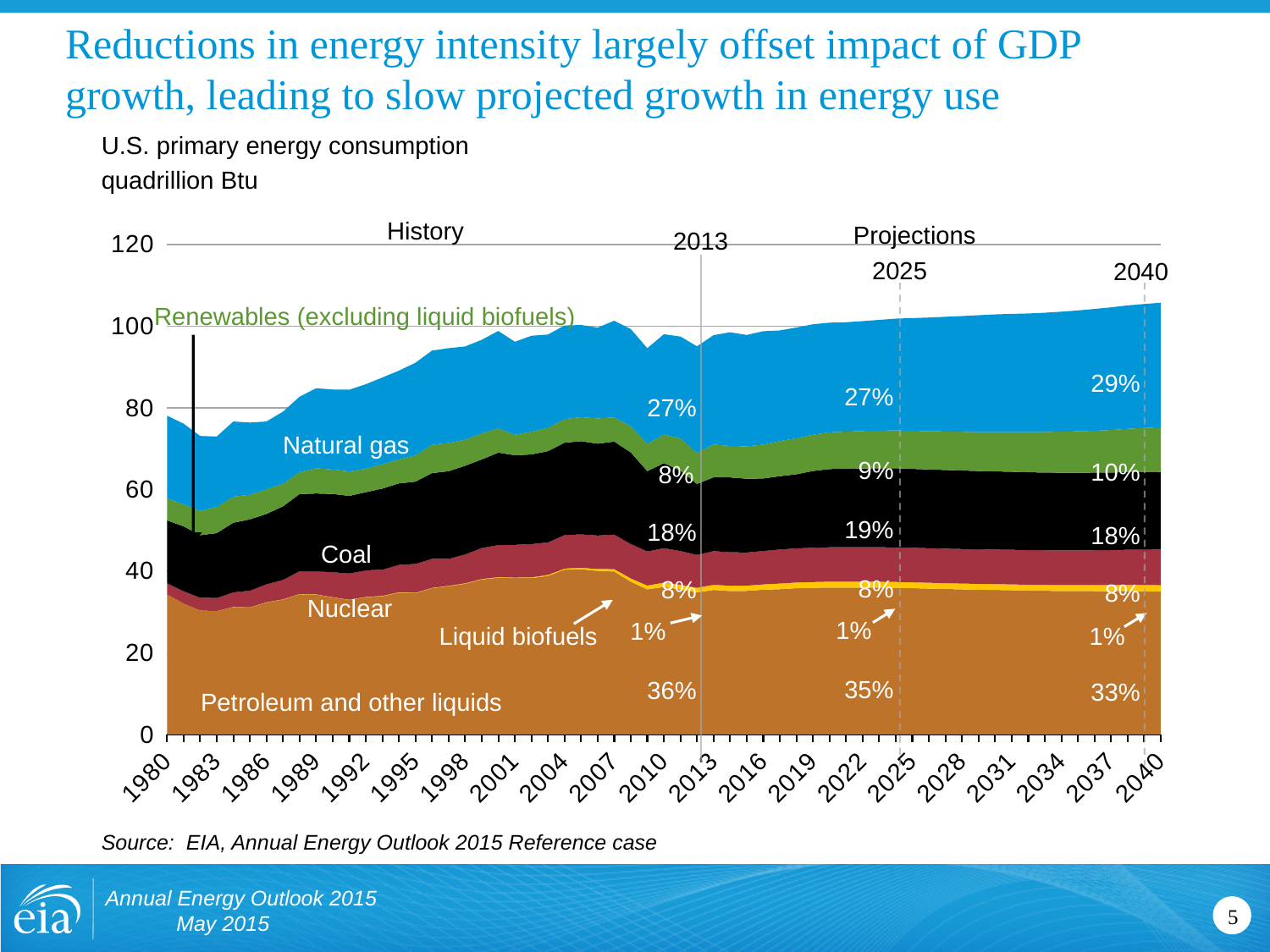
Is total U.S. primary energy consumption in 2040 greater or less than 100 quadrillion Btu? greater What kind of chart is used to show U.S. primary energy consumption? Stacked area chart What share of U.S. primary energy consumption does natural gas account for in 2040? 29% Which energy source has the smallest share of U.S. primary energy consumption in 2025? Liquid biofuels Which energy source has the largest share of U.S. primary energy consumption in 2013? Petroleum and other liquids Does the share of natural gas in U.S. primary energy consumption rise or fall between 2013 and 2040? Rise What share of U.S. primary energy consumption does coal account for in 2025? 19% In 2040, which has the larger share of U.S. primary energy consumption: natural gas or petroleum and other liquids? Petroleum and other liquids By how many percentage points does the share of petroleum and other liquids fall between 2013 and 2040? 3 percentage points How many energy sources are shown as separate areas in the chart? 6 What share of U.S. primary energy consumption does petroleum and other liquids account for in 2013? 36% What share of U.S. primary energy consumption do renewables (excluding liquid biofuels) account for in 2040? 10%